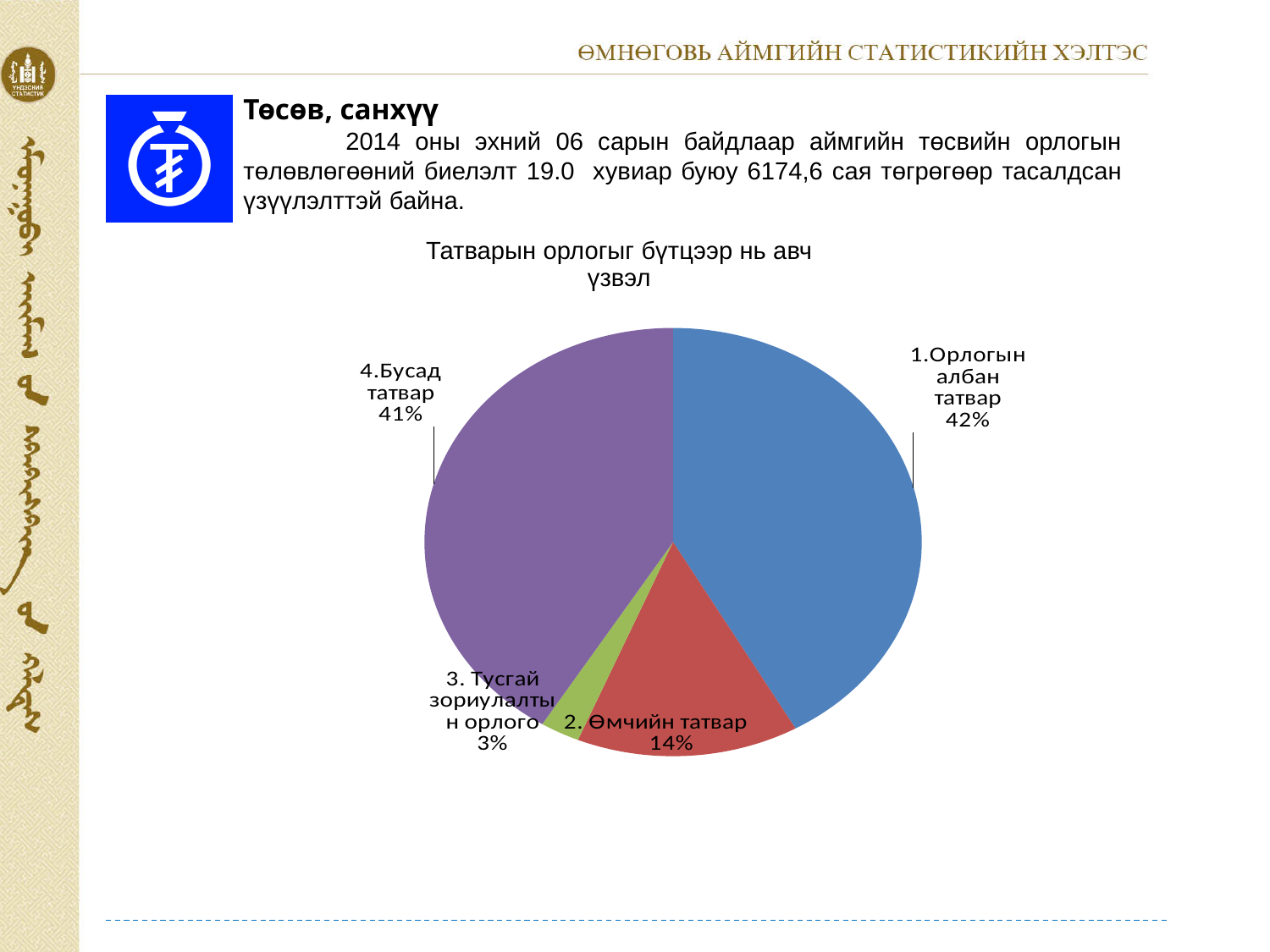
What is the difference in percentage points between 1.Орлогын албан татвар and 2. Өмчийн татвар? 28 How many slices does the pie chart have? 4 Which category has the largest slice of the pie? 1.Орлогын албан татвар What share of the pie is 1.Орлогын албан татвар? 42% Which is larger, the share for 2. Өмчийн татвар or the share for 4.Бусад татвар? 4.Бусад татвар What share of the pie is 4.Бусад татвар? 41% What is the title of the pie chart? Татварын орлогыг бүтцээр нь авч үзвэл What kind of chart is shown on the slide? pie chart Which category has the smallest slice of the pie? 3. Тусгай зориулалтын орлого What colour is the slice for 2. Өмчийн татвар? red What share of the pie is 2. Өмчийн татвар? 14%